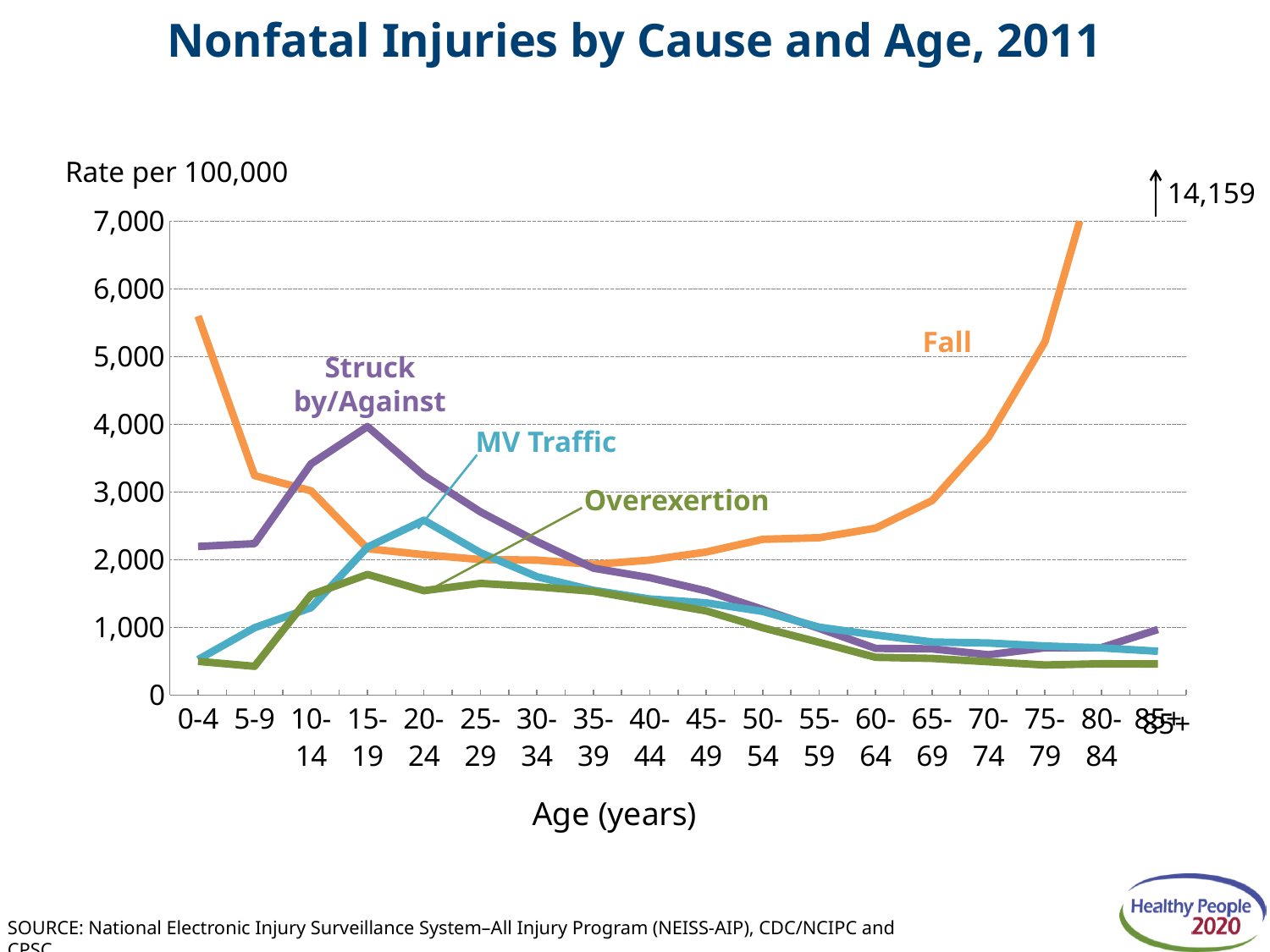
What kind of chart is shown on the slide? line chart Does the Fall rate rise or fall from the 50-54 age group to the 85+ age group? rise Which cause has the highest nonfatal injury rate for the 0-4 age group? Fall Is the Fall rate for the 0-4 age group greater or less than 5,000? greater How many age groups are shown along the x axis? 18 Which cause has the lowest injury rate for the 75-79 age group? Overexertion Is the Struck by/Against rate for the 15-19 age group greater or less than 3,000? greater What is the Fall injury rate for the 85+ age group, as annotated on the chart? 14,159 What is the title of the chart? Nonfatal Injuries by Cause and Age, 2011 How many injury causes (series) are plotted on the chart? 4 For the 15-19 age group, which is higher: the Struck by/Against rate or the Fall rate? Struck by/Against Is the Overexertion rate for the 15-19 age group greater or less than 2,000? less